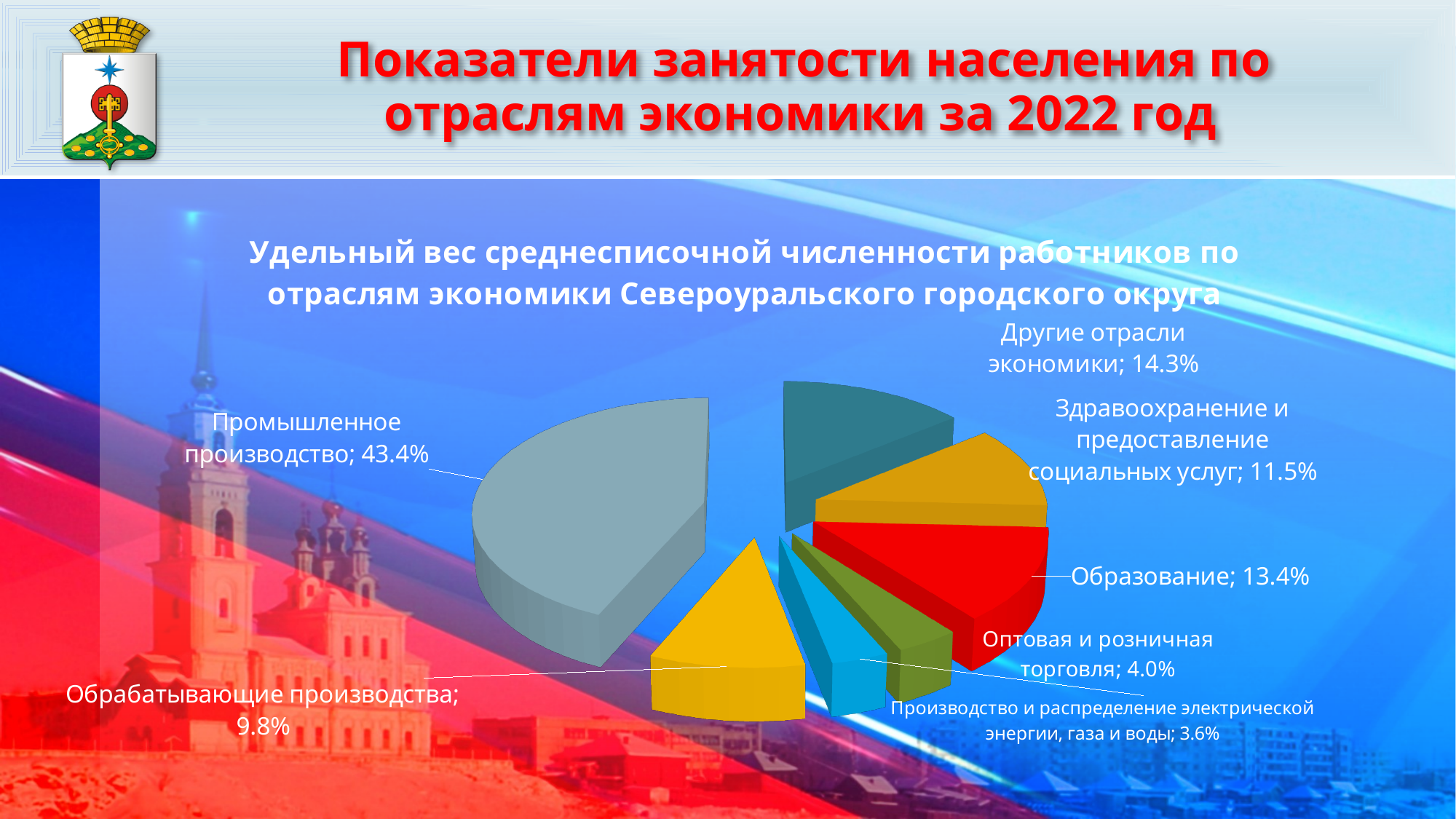
Сколько отраслей (секторов) показано на круговой диаграмме? 7 Какова доля отрасли «Промышленное производство» на диаграмме? 43.4% Каким цветом на диаграмме показан сектор «Образование»? Красным Какая отрасль имеет наименьшую долю на диаграмме? Производство и распределение электрической энергии, газа и воды Какая отрасль имеет наибольшую долю на диаграмме? Промышленное производство Какой тип диаграммы показан на слайде? Круговая диаграмма Какова доля отрасли «Образование» на диаграмме? 13.4% Какова доля отрасли «Здравоохранение и предоставление социальных услуг»? 11.5% Что больше: доля «Обрабатывающие производства» или доля «Оптовая и розничная торговля»? Обрабатывающие производства На сколько процентных пунктов доля «Другие отрасли экономики» больше доли «Образование»? 0.9 Какова сумма долей отраслей «Образование» и «Здравоохранение и предоставление социальных услуг»? 24.9% Какова доля отрасли «Производство и распределение электрической энергии, газа и воды»? 3.6%